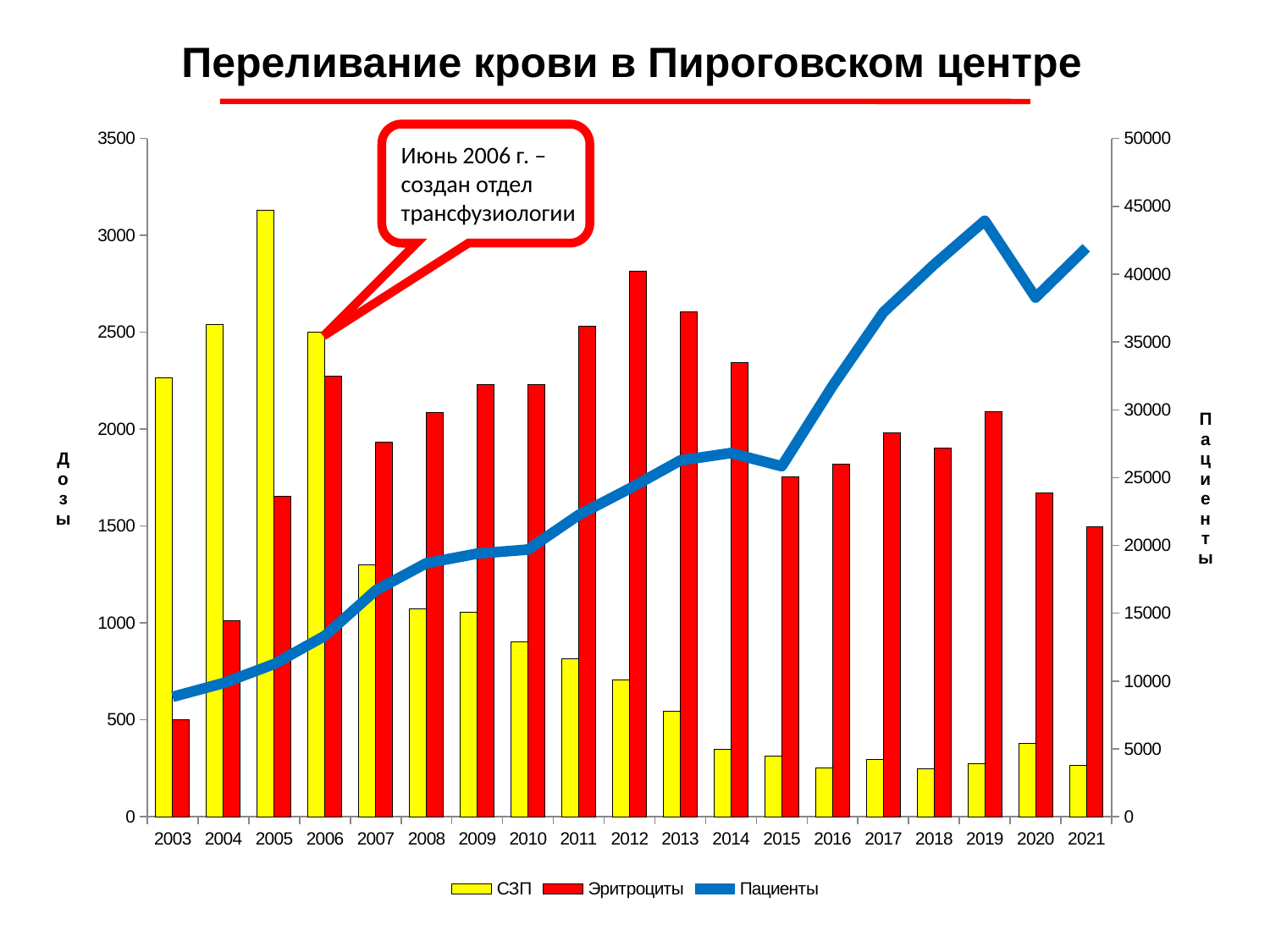
What is the title of the chart on the slide? Переливание крови в Пироговском центре Is the Эритроциты value for 2015 greater or less than 2000? less How many years are shown on the x axis of the chart? 19 What kind of chart is shown on the slide? A combined bar and line chart In 2004, which is larger: the СЗП bar or the Эритроциты bar? СЗП In which year is the Эритроциты bar the highest? 2012 In which year is the СЗП bar the highest? 2005 Does the Пациенты line generally rise or fall from 2003 to 2019? Rise Is the Пациенты value for 2019 greater or less than 40000? greater Is the СЗП value for 2003 greater or less than 2000? greater In which year is the Эритроциты bar the lowest? 2003 How many series does the legend list? 3